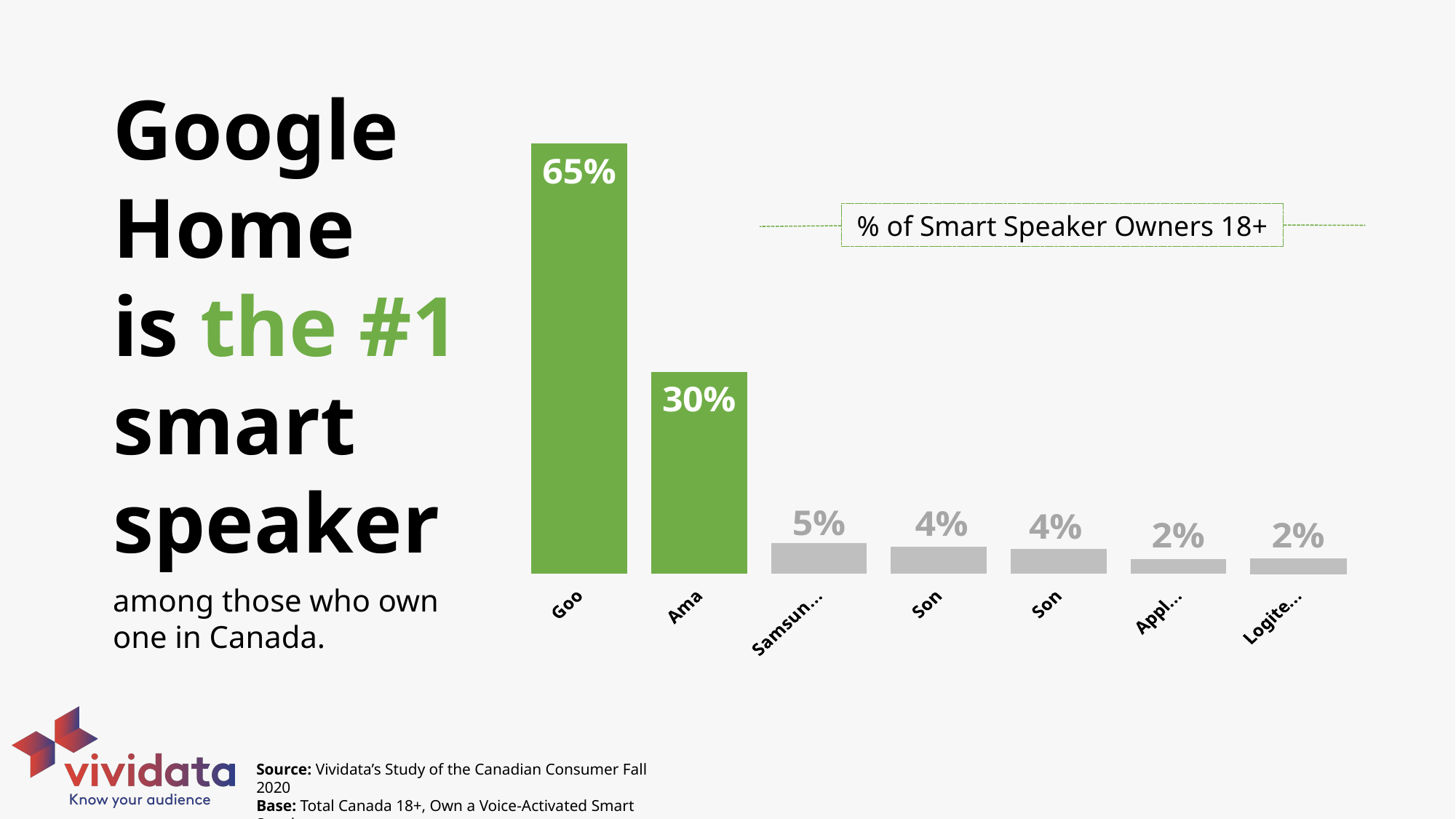
How many bars are plotted in the chart? 7 What kind of chart is shown on the slide? Bar chart What is the difference between the second bar ("Ama") and the third bar ("Samsun...")? 25% What is the value of the first bar, labelled "Goo"? 65% Which is larger, the value for "Ama" or the value for "Samsun..."? Ama Do the values rise or fall from left to right across the bars? Fall What is the value of the second bar, labelled "Ama"? 30% Which bar has the highest value? Goo What is the value of the third bar, labelled "Samsun..."? 5% What is the difference between the first bar ("Goo") and the second bar ("Ama")? 35% What is the value of the last bar, labelled "Logite..."? 2% What is the title shown in the box next to the chart? % of Smart Speaker Owners 18+